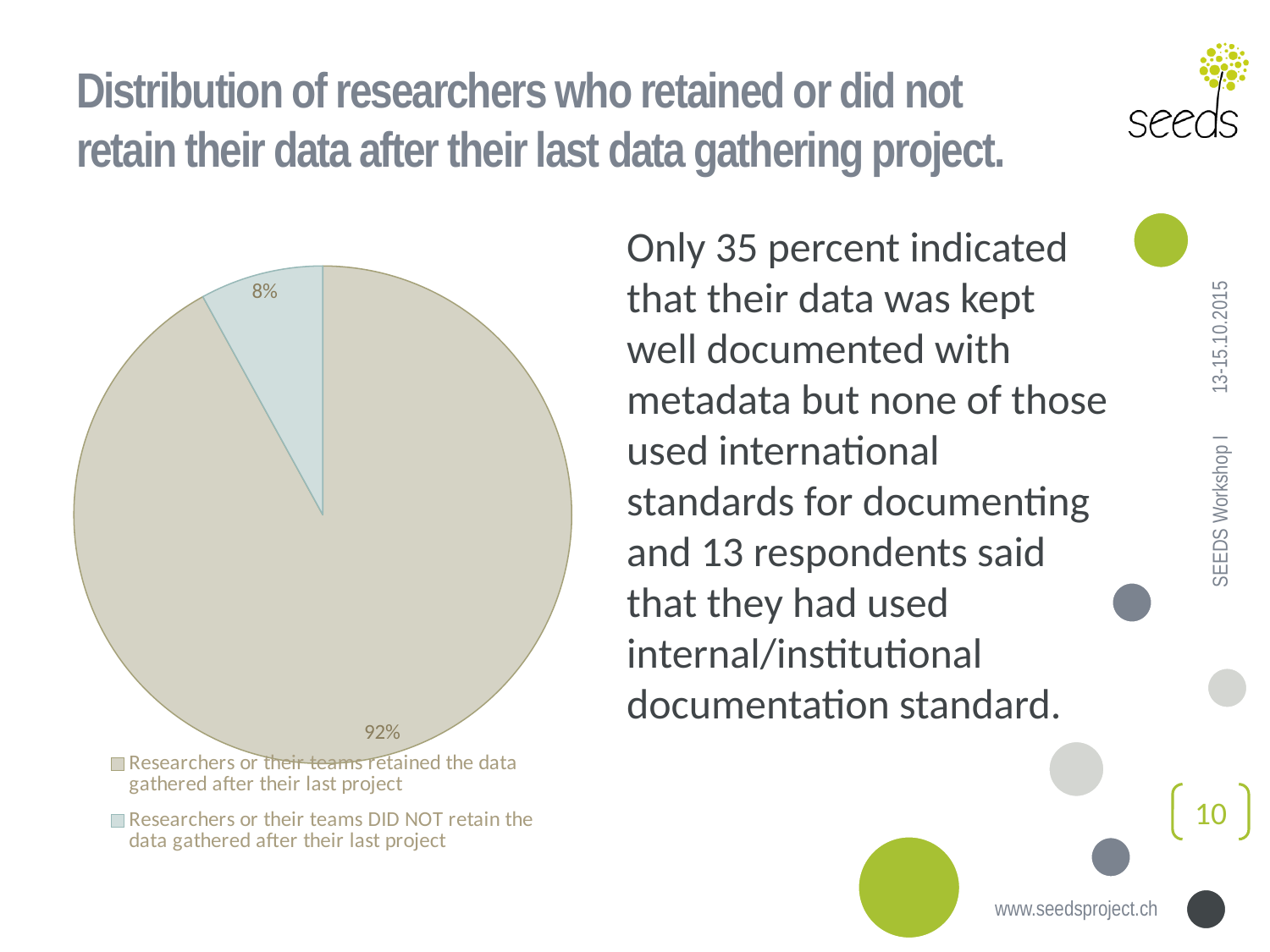
What is the difference in percentage points between the slice for researchers who retained the data and the slice for those who did not? 84 Which slice of the pie is the smallest? Researchers or their teams DID NOT retain the data gathered after their last project How many entries does the legend list? 2 Which slice of the pie is the largest? Researchers or their teams retained the data gathered after their last project What kind of chart is shown on the slide? pie chart What share of the pie is for researchers or their teams who DID NOT retain the data gathered after their last project? 8% What is the total of the two percentages shown on the pie chart? 100% Which is larger: the slice for researchers who retained the data or the slice for those who did not retain the data? Researchers or their teams retained the data gathered after their last project What is the title of the chart on the slide? Distribution of researchers who retained or did not retain their data after their last data gathering project. What share of the pie is for researchers or their teams who retained the data gathered after their last project? 92% How many slices does the pie chart have? 2